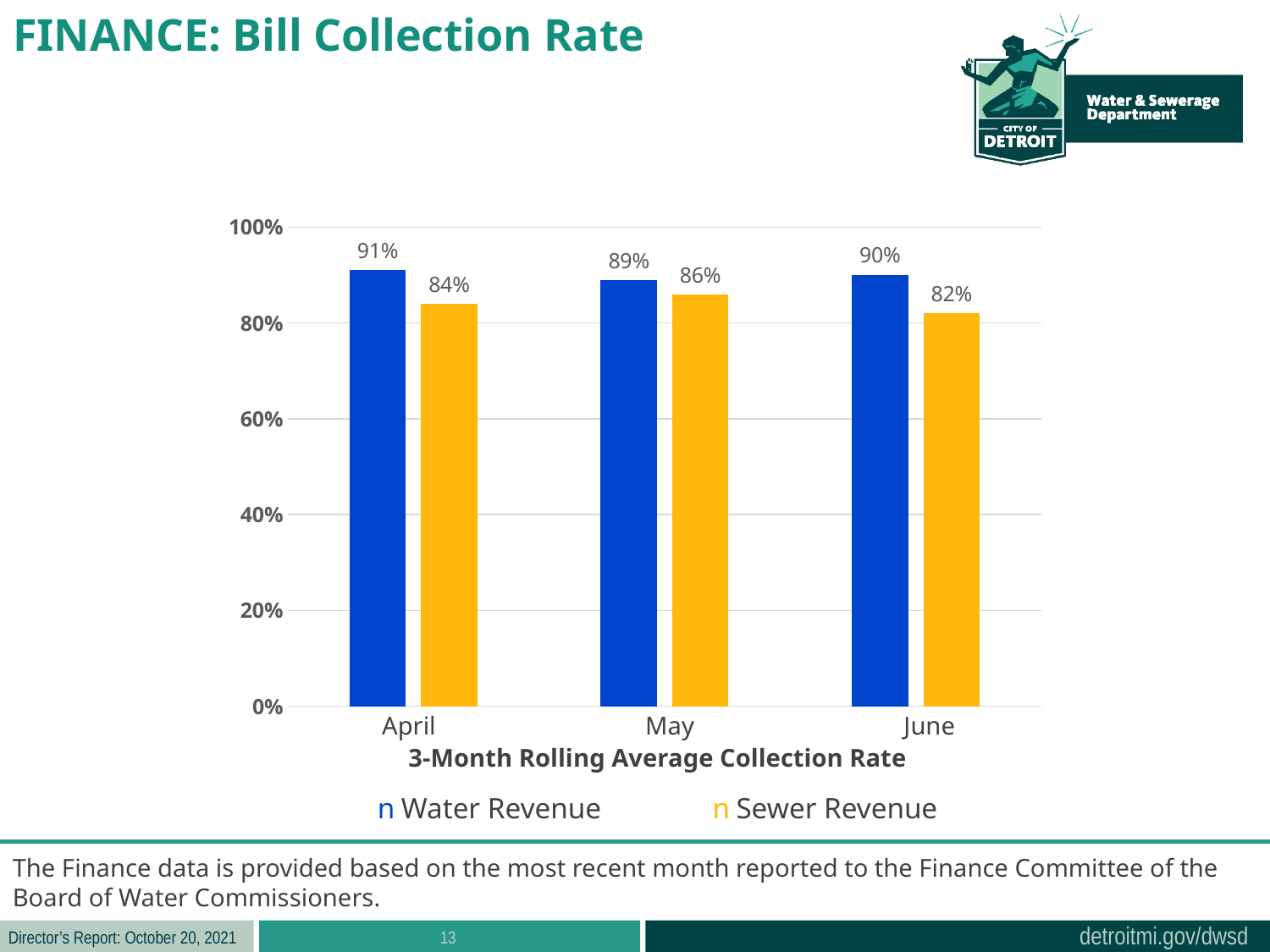
How many months are shown on the x axis? 3 In which month is the Sewer Revenue collection rate lowest? June In which month is the Water Revenue collection rate highest? April How many series does the legend list? 2 What is the x-axis title of the chart? 3-Month Rolling Average Collection Rate What is the difference between the Water Revenue and Sewer Revenue collection rates in June? 8% Which is larger in May, the Water Revenue or the Sewer Revenue collection rate? Water Revenue What is the difference between the Water Revenue collection rate in April and in May? 2% What is the Sewer Revenue collection rate for May? 86% What kind of chart is shown on the slide? Bar chart What is the Sewer Revenue collection rate for June? 82% What is the Water Revenue collection rate for April? 91%